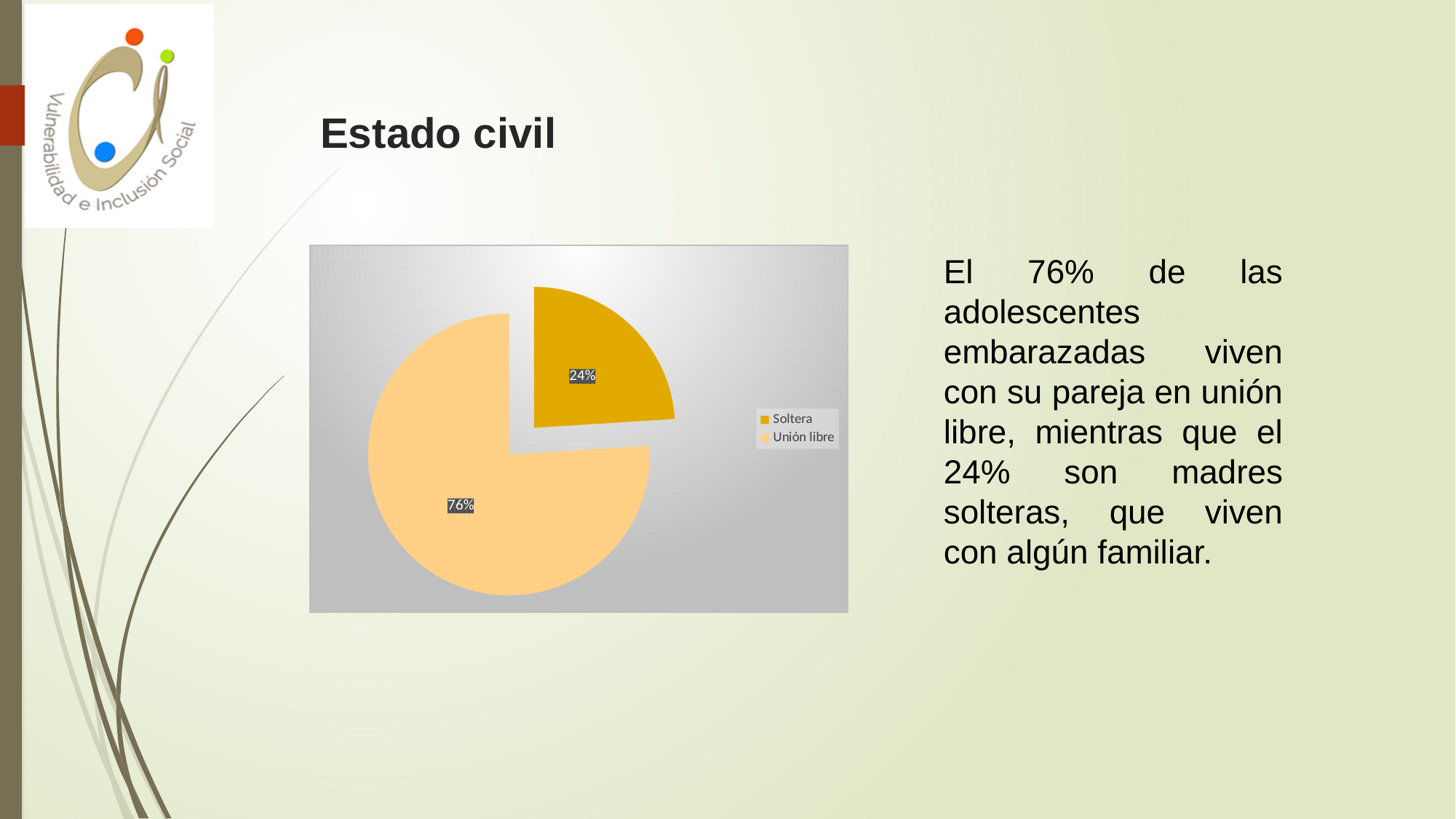
How many entries does the legend list? 2 Which legend entry is shown in the darker gold colour? Soltera What is the title of the slide containing the chart? Estado civil Which is larger, the Soltera slice or the Unión libre slice? Unión libre Which category has the largest slice of the pie? Unión libre Which category has the smallest slice of the pie? Soltera How many categories does the pie chart show? 2 What kind of chart is shown on the slide? Pie chart What share of the pie does Unión libre represent? 76% What share of the pie does Soltera represent? 24% What is the difference in percentage points between Unión libre and Soltera? 52